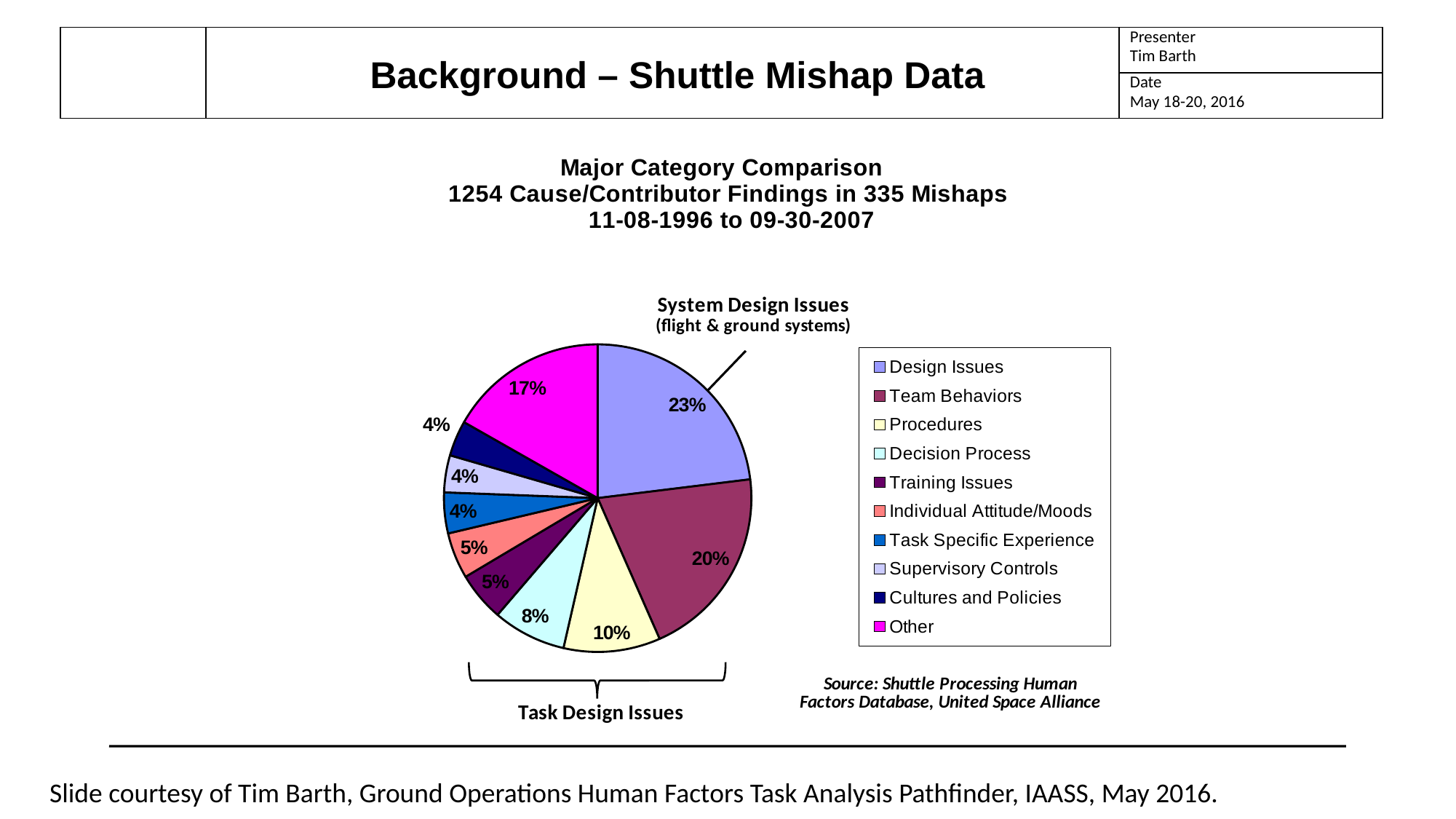
What share of the pie is labelled Other? 17% Which category has the largest slice of the pie? Design Issues What is the title of the chart? Major Category Comparison 1254 Cause/Contributor Findings in 335 Mishaps 11-08-1996 to 09-30-2007 What percentage is shown for Procedures? 10% Which is larger, the Procedures slice or the Decision Process slice? Procedures What colour is the Other slice of the pie? Magenta What is the combined share of Design Issues and Team Behaviors? 43% What kind of chart is shown on the slide? Pie chart How many categories does the legend list? 10 What is the difference in percentage points between Design Issues and Team Behaviors? 3 What share of the pie does Design Issues account for? 23% What percentage is shown for Team Behaviors? 20%